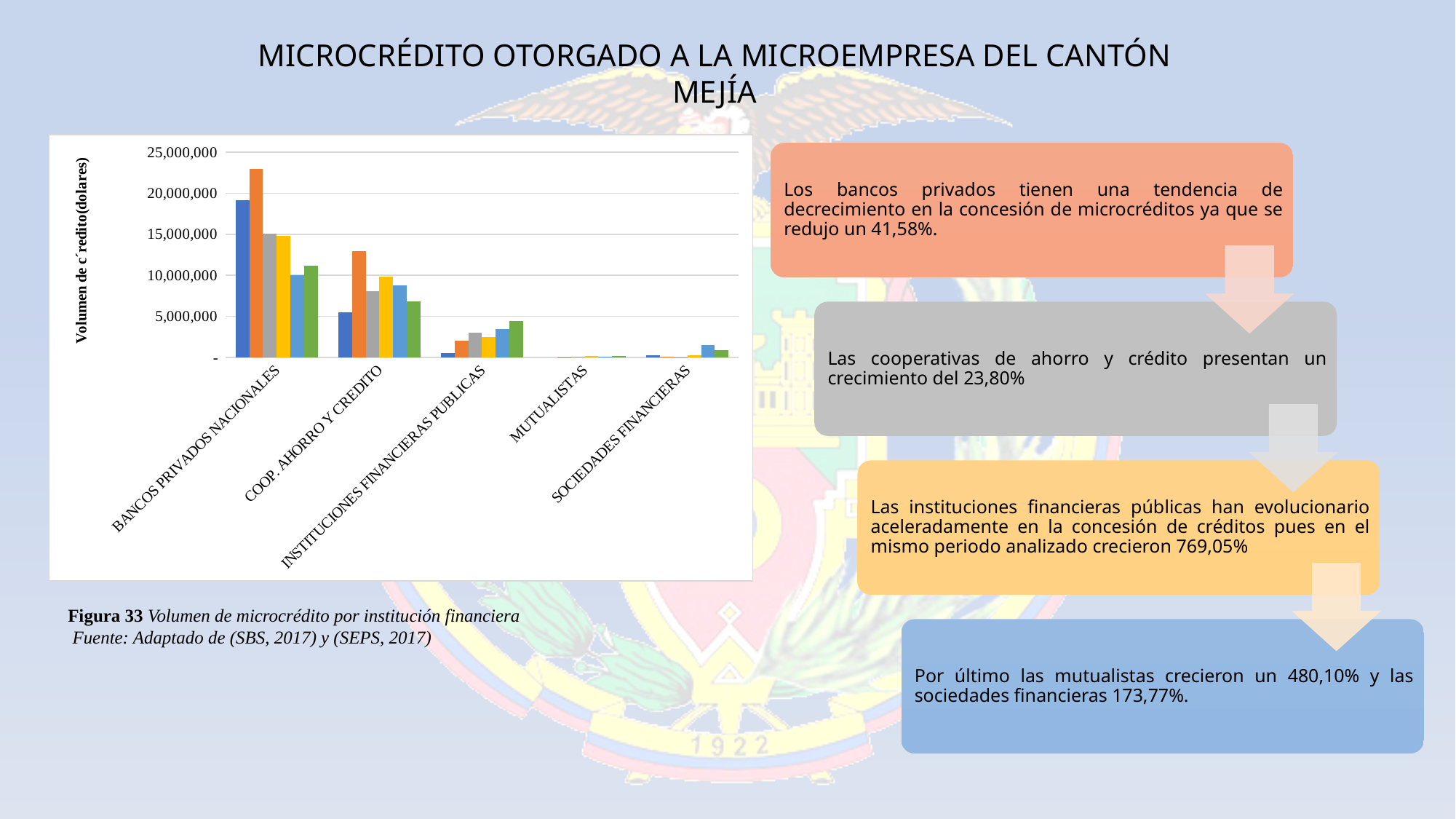
Which category has the lowest bars in the chart? MUTUALISTAS Do the values generally rise or fall moving from left to right along the x axis? Fall Which category has the highest bars in the chart? BANCOS PRIVADOS NACIONALES How many bars are plotted for each category in the chart? 6 What kind of chart is shown on the slide? Bar chart Is the tallest bar for BANCOS PRIVADOS NACIONALES greater or less than 20,000,000? greater Which category has larger values, BANCOS PRIVADOS NACIONALES or COOP. AHORRO Y CREDITO? BANCOS PRIVADOS NACIONALES Is the tallest bar for COOP. AHORRO Y CREDITO greater or less than 10,000,000? greater Is the first (blue) bar for BANCOS PRIVADOS NACIONALES greater or less than 20,000,000? less What is the label on the vertical axis of the chart? Volumen de c´redito(dolares) How many categories are shown on the x axis of the chart? 5